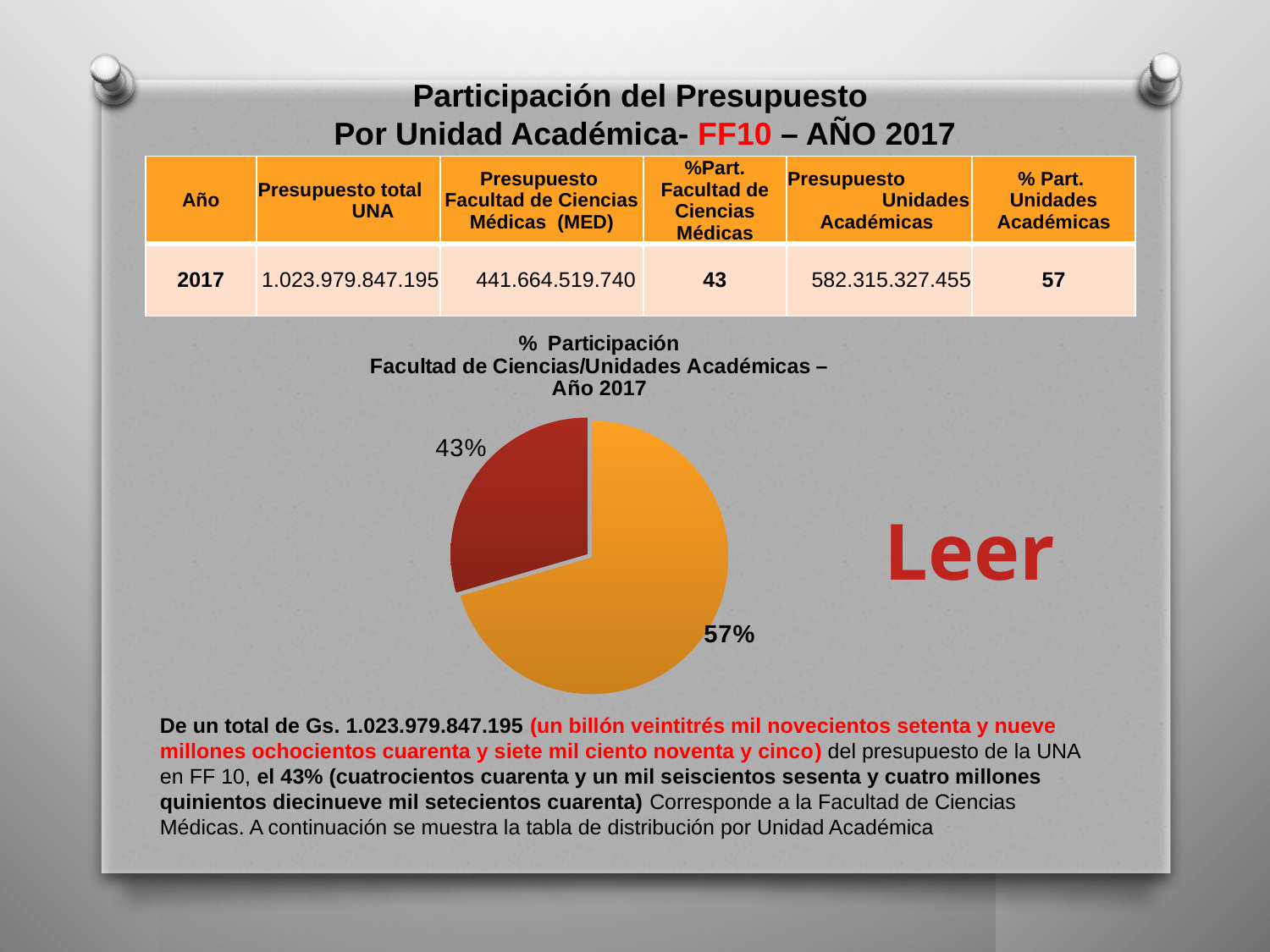
In the pie chart, what is the share for the Facultad de Ciencias Médicas? 43% What share of the pie chart does the red slice represent? 43% Which slice of the pie chart is the smallest? 43% In the pie chart, what is the share for the Unidades Académicas? 57% What is the title of the pie chart? % Participación Facultad de Ciencias/Unidades Académicas – Año 2017 What colour is the slice labelled 43% in the pie chart? red Is the share for the Facultad de Ciencias Médicas larger or smaller than the share for the Unidades Académicas? smaller Which slice of the pie chart is the largest? 57% How many slices does the pie chart have? 2 What kind of chart is shown on the slide? pie chart What share of the pie chart does the orange slice represent? 57% What is the difference in percentage points between the two slices of the pie chart? 14